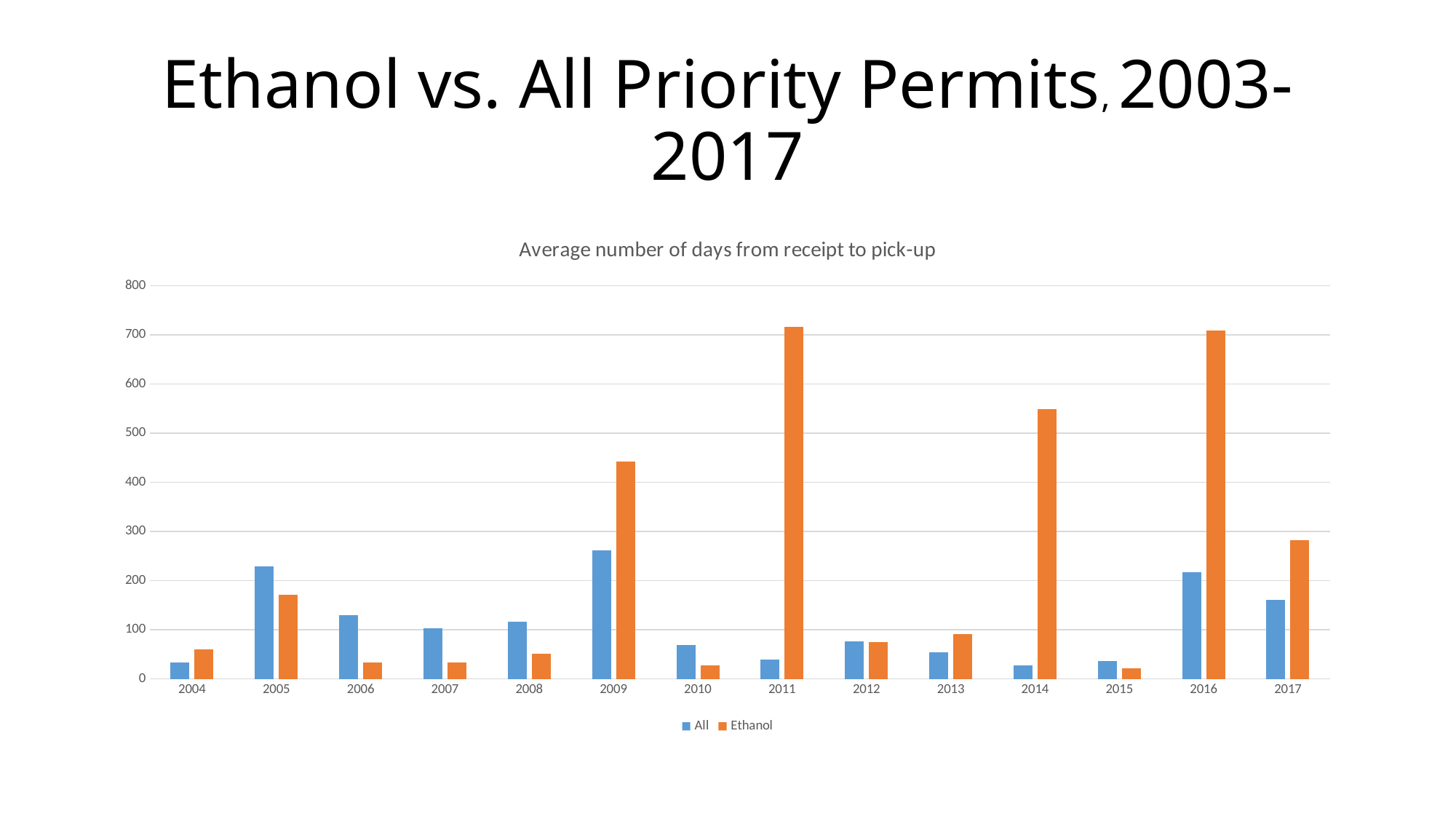
Is the Ethanol value for 2009 greater or less than 400? greater Is the Ethanol value for 2014 greater or less than 500? greater Is the All value for 2005 greater or less than 200? greater What kind of chart is shown on the slide? bar chart How many years are shown on the x axis? 14 In which year is the All series highest? 2009 What is the chart's title? Average number of days from receipt to pick-up Which series is shown in orange? Ethanol How many series does the legend list? 2 In 2005, which is larger, the All value or the Ethanol value? All